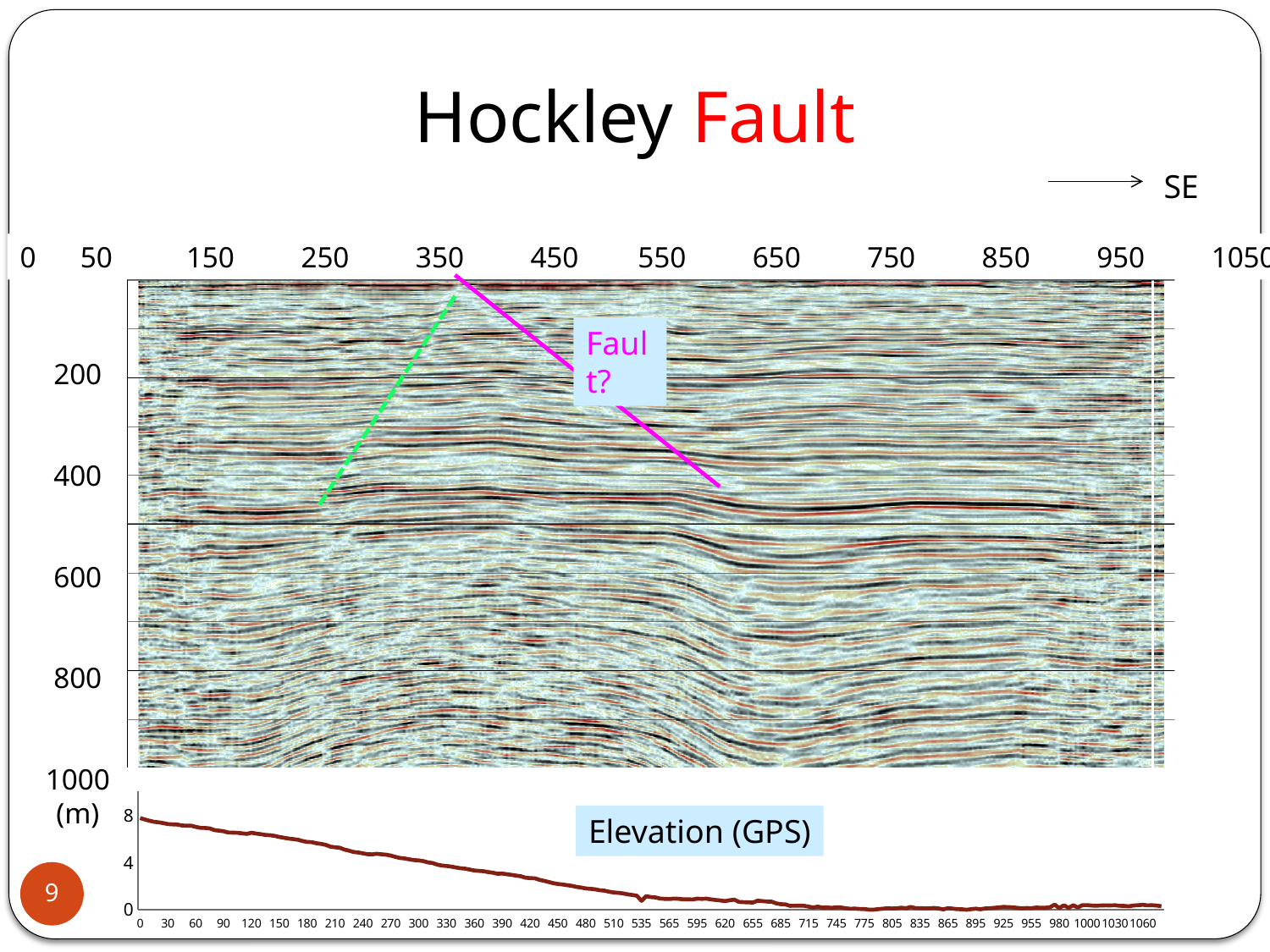
In the Elevation (GPS) chart, is the elevation at x = 120 greater or less than 4? greater In the Elevation (GPS) chart, is the elevation at x = 600 greater or less than 4? less In the Elevation (GPS) chart, is the elevation at x = 900 greater or less than 4? less In the Elevation (GPS) chart, which has the larger elevation: x = 0 or x = 1060? x = 0 What is the highest tick value shown on the y axis of the Elevation (GPS) chart? 8 What kind of chart is the Elevation (GPS) chart at the bottom of the slide? line chart What is the last tick label on the x axis of the Elevation (GPS) chart? 1060 In the Elevation (GPS) chart, at which end of the x axis is the elevation highest? the left end (x = 0) In the Elevation (GPS) chart, do the values rise or fall from left to right along the x axis? fall